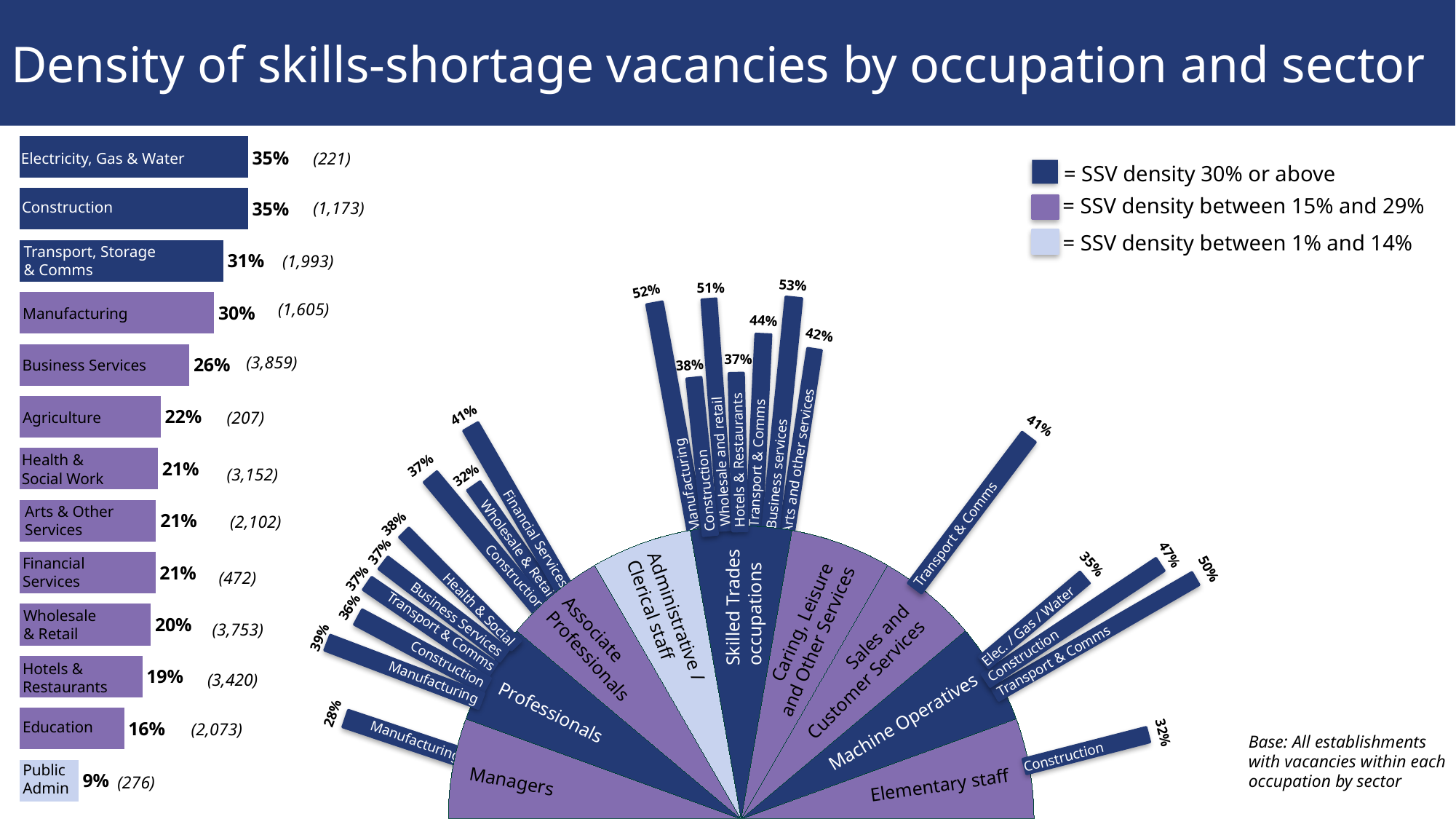
In the semicircular chart on the right, what is the SSV density for Manufacturing within Managers? 28% In the left bar chart, which sector has the lowest SSV density? Public Admin In the left bar chart, what is the base number shown in brackets for Business Services? (3,859) In the semicircular chart on the right, what is the SSV density for Transport & Comms within Machine Operatives? 50% How many sectors are listed in the left bar chart? 13 How many entries does the legend list? 3 What type of chart is shown on the left of the slide? Bar chart In the left bar chart, what is the SSV density for Education? 16% In the left bar chart, which has the higher SSV density, Agriculture or Hotels & Restaurants? Agriculture In the left bar chart, what is the SSV density for Manufacturing? 30% In the left bar chart, what is the difference in SSV density between Construction and Business Services? 9 percentage points In the semicircular chart on the right, what is the SSV density for Business services within Skilled Trades occupations? 53%